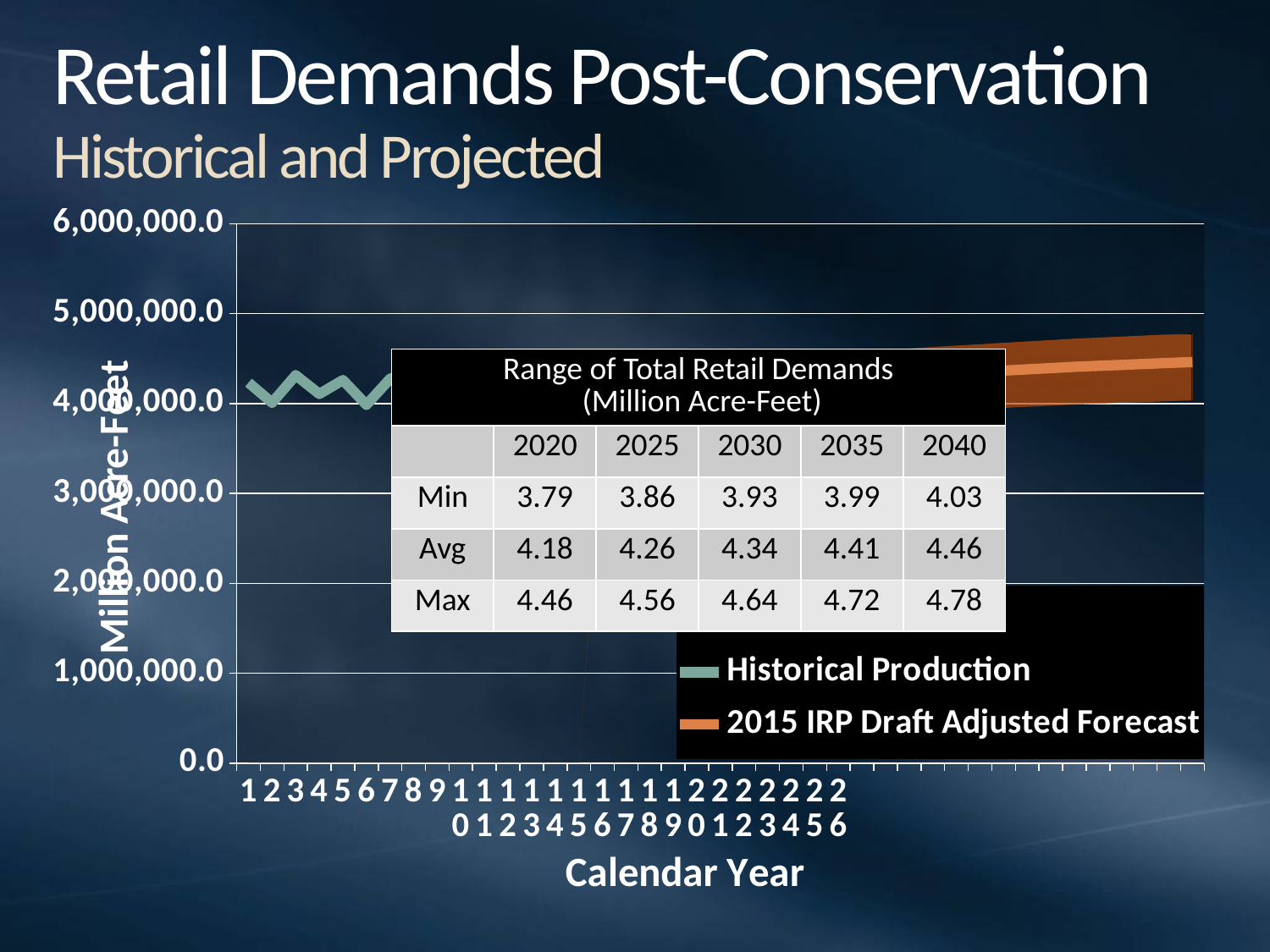
What are the two series named in the chart legend? Historical Production; 2015 IRP Draft Adjusted Forecast How many series does the chart legend list? 2 Is the 2015 IRP Draft Adjusted Forecast band greater or less than 3,000,000.0 on the y axis? greater What kind of chart is shown on the slide? combination area and line chart In the Range of Total Retail Demands table, what is the difference between the Max and Min values for 2040? 0.75 In the Range of Total Retail Demands table, what is the Max value for 2040? 4.78 In the Range of Total Retail Demands table, what is the Avg value for 2030? 4.34 Is the 2015 IRP Draft Adjusted Forecast band greater or less than 5,000,000.0 on the y axis? less Does the 2015 IRP Draft Adjusted Forecast rise or fall as it moves to the right along the x axis? rise What is the title of the chart's x axis? Calendar Year In the Range of Total Retail Demands table, which year has the highest Avg value? 2040 In the Range of Total Retail Demands table, what is the Min value for 2020? 3.79